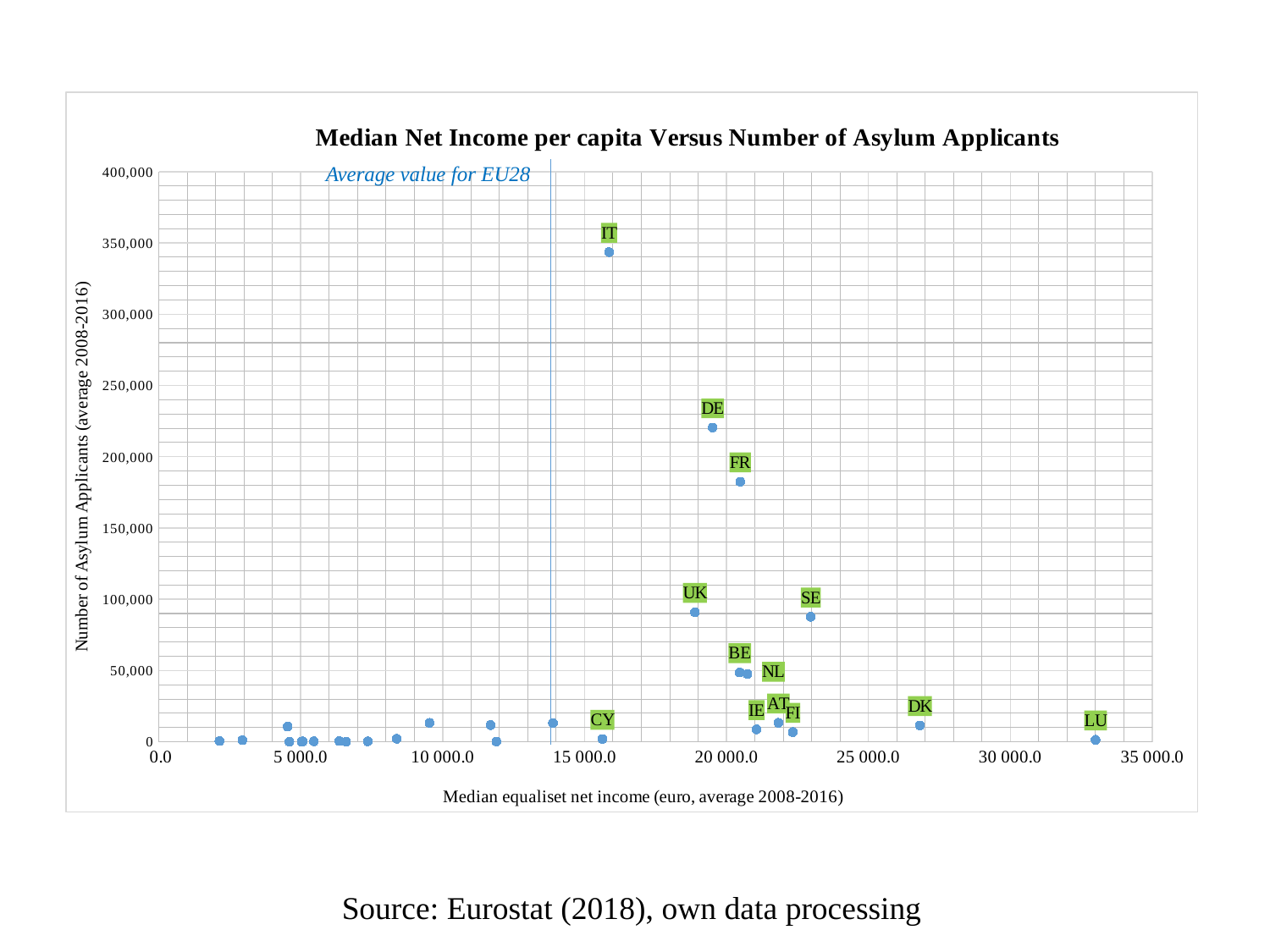
What is the title of the chart? Median Net Income per capita Versus Number of Asylum Applicants What kind of chart is shown on the slide? Scatter chart Is the number of asylum applicants for FR greater or less than 200,000? less Is the number of asylum applicants for LU greater or less than 50,000? less What does the vertical line in the chart represent, according to its label? Average value for EU28 Is the number of asylum applicants for IT greater or less than 300,000? greater Which labelled country has the highest number of asylum applicants? IT Which has more asylum applicants, IT or DE? IT Which has more asylum applicants, DE or FR? DE